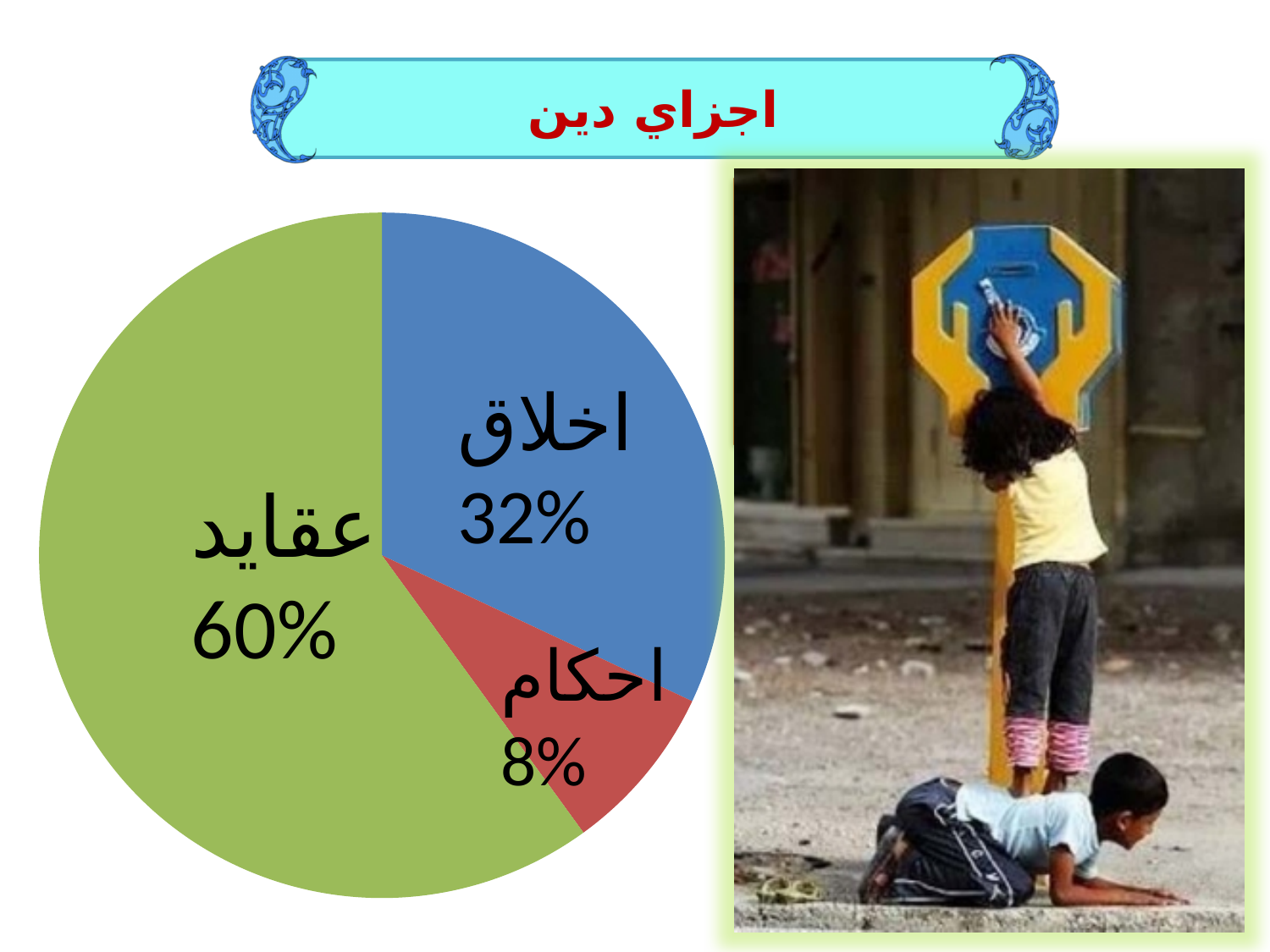
What is the title shown at the top of the slide? اجزاي دين How many slices does the pie chart have? 3 What share of the pie does the عقاید slice represent? 60% Which slice of the pie chart is the largest? عقاید What colour is the عقاید slice of the pie chart? Green Which is larger, the اخلاق slice or the احکام slice? اخلاق What kind of chart is shown on the slide? Pie chart Which slice of the pie chart is the smallest? احکام What share of the pie does the احکام slice represent? 8% What is the difference in percentage points between the اخلاق slice and the احکام slice? 24 What share of the pie does the اخلاق slice represent? 32% What is the difference in percentage points between the عقاید slice and the اخلاق slice? 28